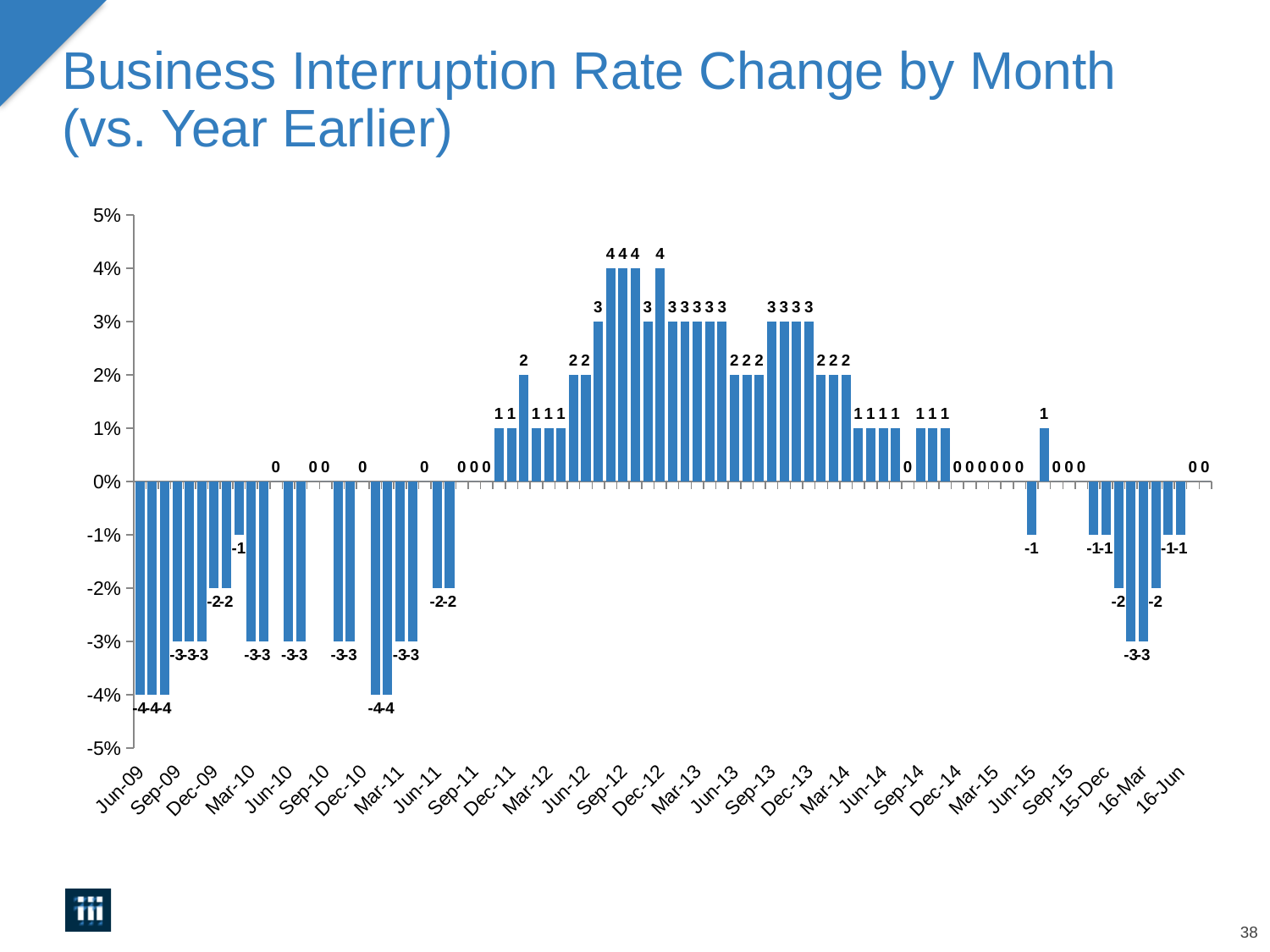
Are the bars for 2009 positive or negative? negative What is the difference between the highest data label (4) and the lowest data label (-4) in the chart? 8 Which has the larger value, Jun-09 or Sep-12? Sep-12 Do the values generally rise or fall from Jun-09 to Sep-12? rise What is the title of the chart? Business Interruption Rate Change by Month (vs. Year Earlier) What is the highest data label value shown in the chart? 4 Is the value for Jun-09 greater or less than -3%? less Is the value for Sep-12 greater or less than 3%? greater What are the minimum and maximum values shown on the vertical axis? -5% and 5% What kind of chart is shown on the slide? bar chart What is the data label for Jun-09, the first bar in the chart? -4 What is the lowest data label value shown in the chart? -4